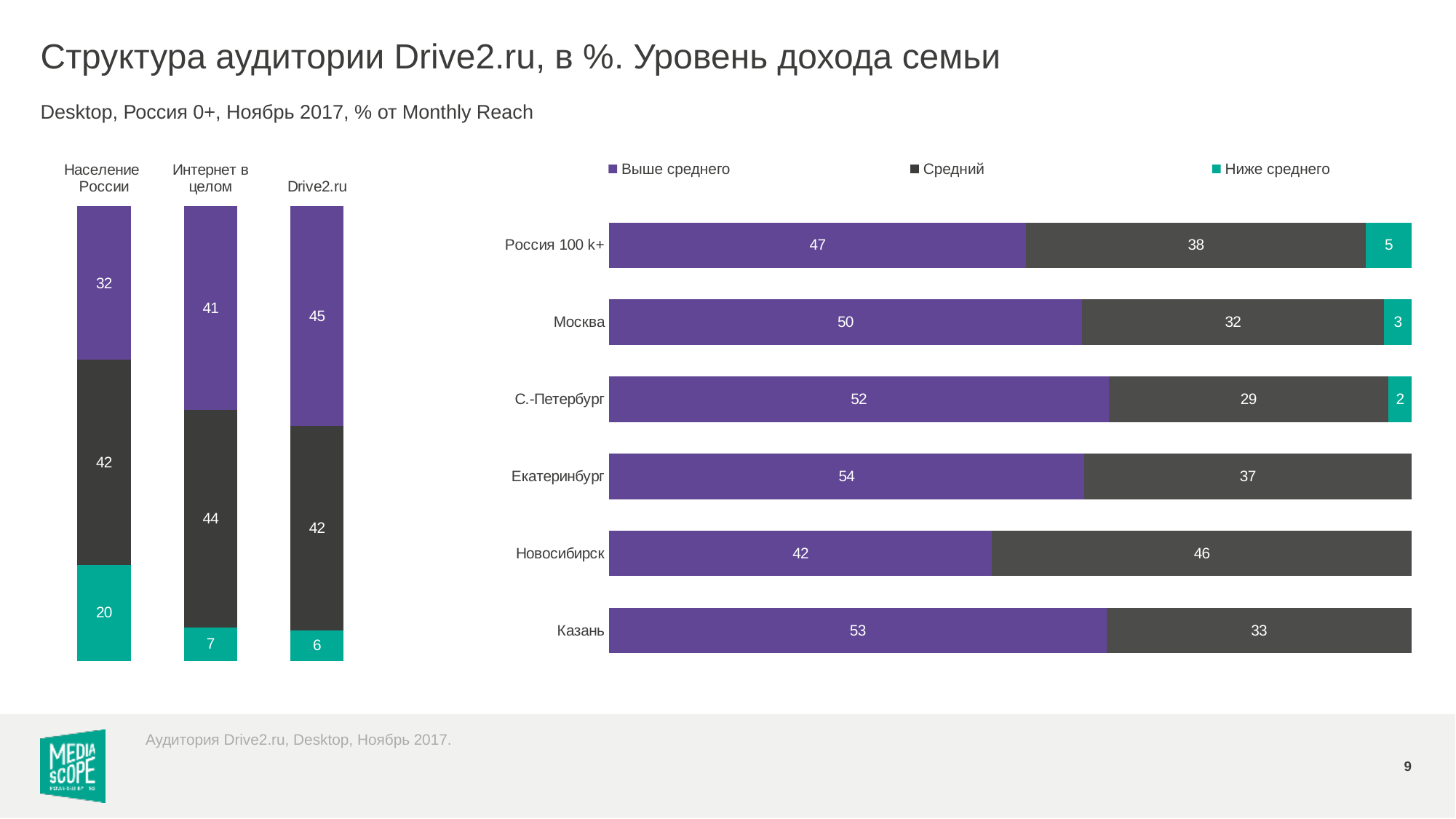
In the right chart, what is the 'Выше среднего' value for Екатеринбург? 54 In the left chart, which of the three bars has the highest 'Средний' value? Интернет в целом In the right chart, what is the 'Средний' value for Новосибирск? 46 In the right chart, what is the total of the Россия 100 k+ bar? 90 How many series does the legend list? 3 In the left chart, which bar has the lowest 'Ниже среднего' value? Drive2.ru In the left chart, what is the difference between the 'Выше среднего' values for Drive2.ru and Население России? 13 In the right chart, which row has the lowest 'Выше среднего' value? Новосибирск In the right chart, is the 'Выше среднего' value larger for Москва or for Казань? Казань In the right chart, which city has the highest 'Выше среднего' value? Екатеринбург In the left chart, what is the 'Выше среднего' value for Drive2.ru? 45 In the left chart, what is the 'Ниже среднего' value for Население России? 20